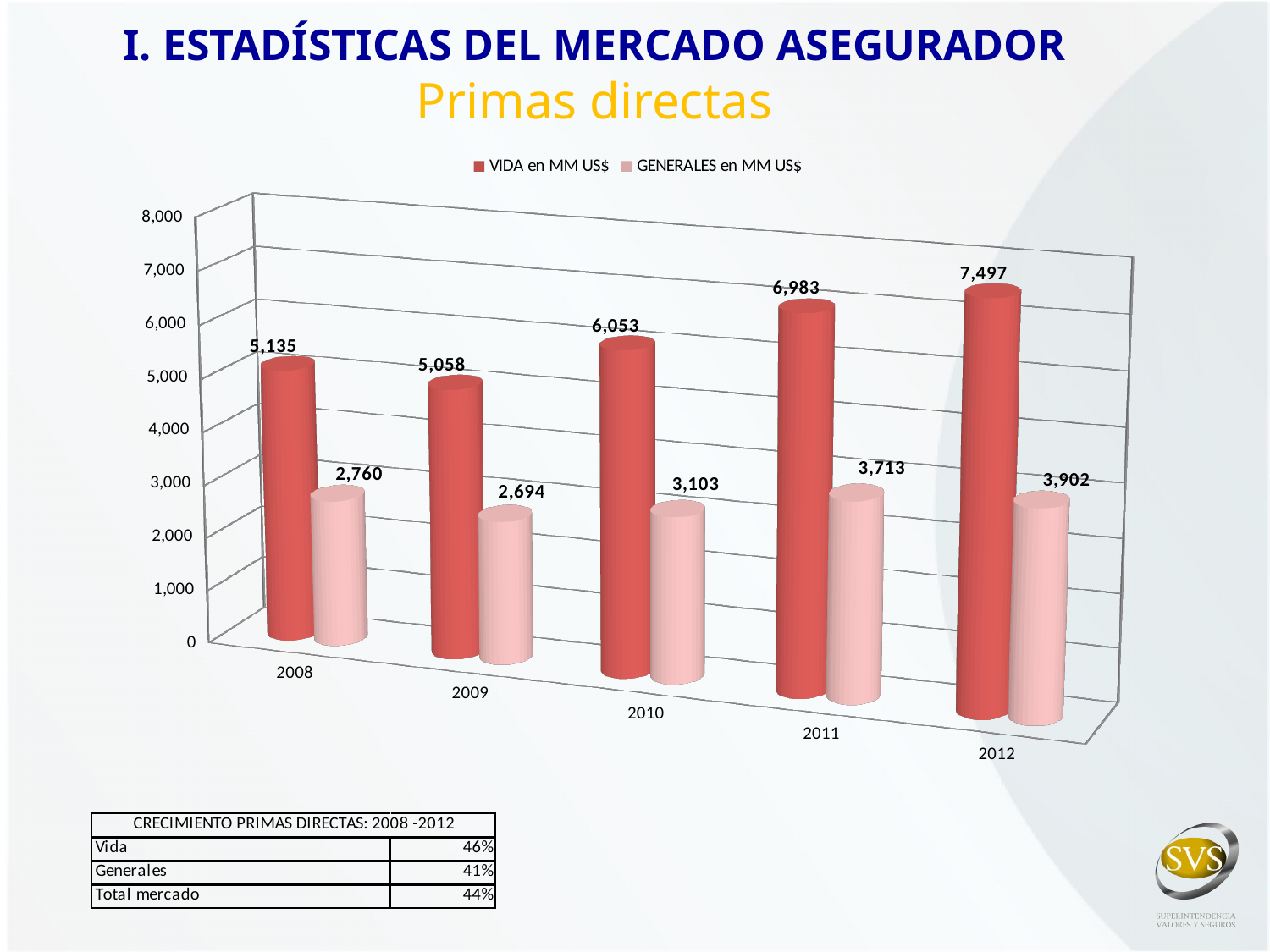
What is the value for VIDA en MM US$ in 2010? 6,053 What is the difference between VIDA en MM US$ and GENERALES en MM US$ in 2012? 3,595 What is the title of the chart? Primas directas Which year has the highest value for VIDA en MM US$? 2012 What kind of chart is shown? bar chart Which is larger, VIDA en MM US$ in 2008 or VIDA en MM US$ in 2009? VIDA en MM US$ in 2008 What is the value for GENERALES en MM US$ in 2011? 3,713 What is the value for VIDA en MM US$ in 2008? 5,135 Do the values for GENERALES en MM US$ rise or fall from 2009 to 2012? rise How many years are shown on the x axis? 5 Which year has the lowest value for GENERALES en MM US$? 2009 How many series does the legend list? 2